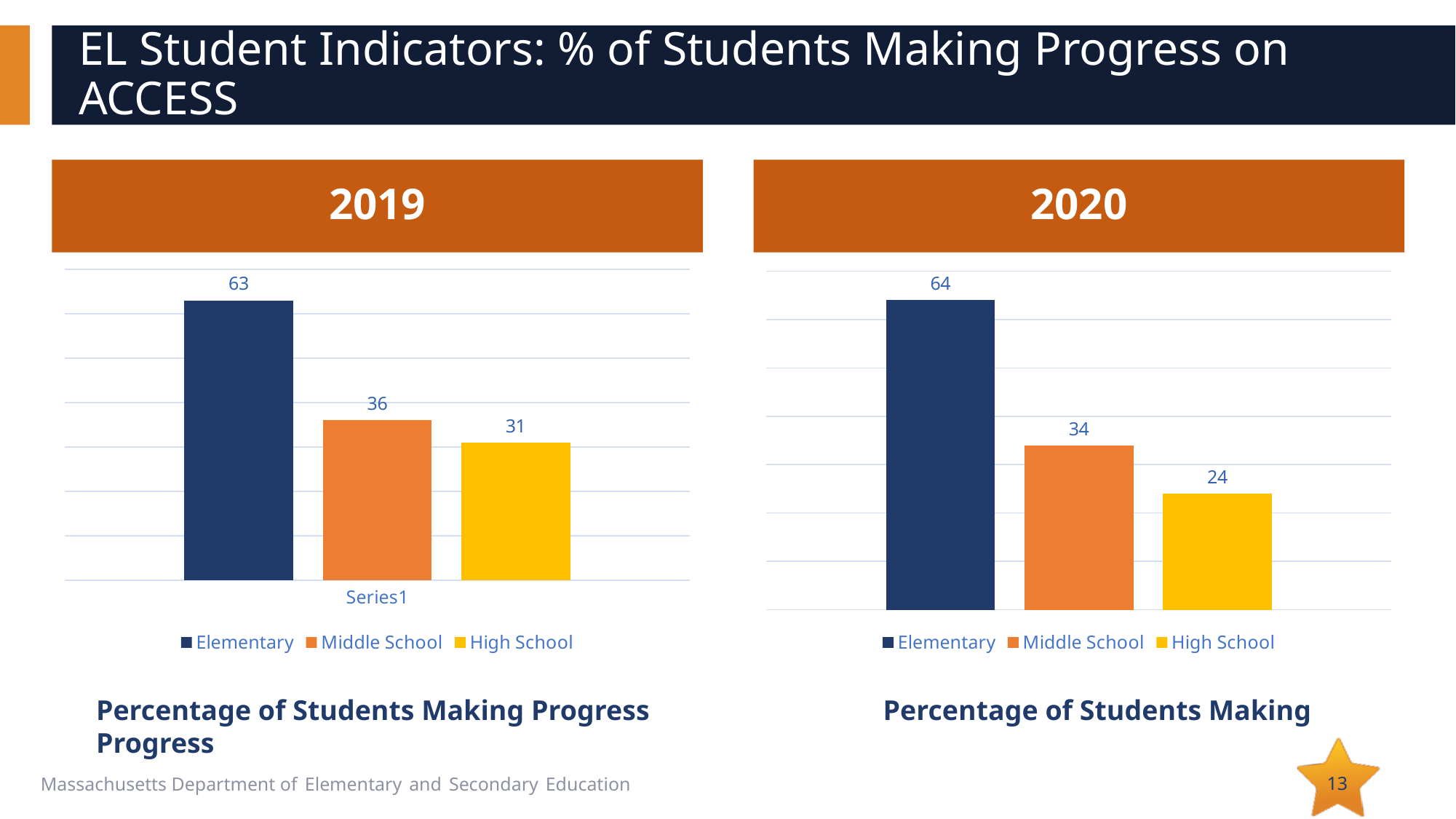
In the 2019 chart, which series has the lowest value? High School Which is larger: the High School value in the 2019 chart or the High School value in the 2020 chart? 2019 In the 2019 chart, what is the difference between the Elementary and Middle School values? 27 In the 2020 chart, which series has the highest value? Elementary In the 2019 chart, what colour is the Middle School bar? Orange What kind of chart is the 2019 chart? Bar chart In the 2020 chart, what is the difference between the Middle School and High School values? 10 In the 2020 chart, what is the value for High School? 24 In the 2019 chart, what is the value for Elementary? 63 In the 2020 chart, what is the value for Middle School? 34 In the 2019 chart, what is the value for High School? 31 How many series does the legend of the 2020 chart list? 3